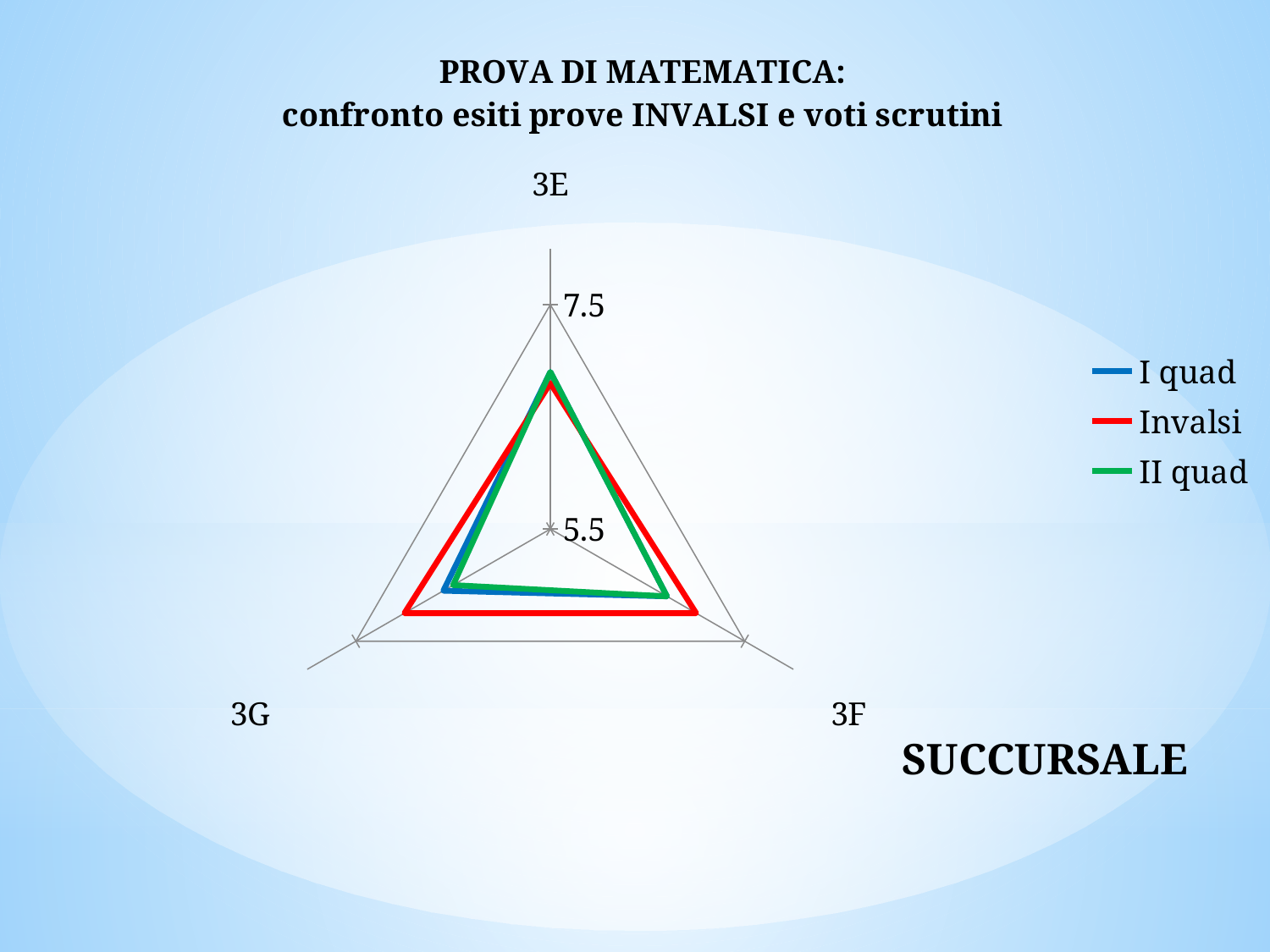
Which series has the highest value for 3G? Invalsi Is the II quad value for 3E greater or less than 5.5? greater Which series is drawn in red? Invalsi Is the Invalsi value for 3G greater or less than 7.5? less For 3G, which series has the larger value, Invalsi or II quad? Invalsi How many series does the legend list? 3 What kind of chart is shown on the slide? Radar chart How many categories (axes) does the radar chart have? 3 For 3F, which series has the larger value, Invalsi or I quad? Invalsi Is the I quad value for 3F greater or less than 7.5? less Which category has the lowest Invalsi value? 3E What is the value shown at the outer ring of the radar chart's axis? 7.5